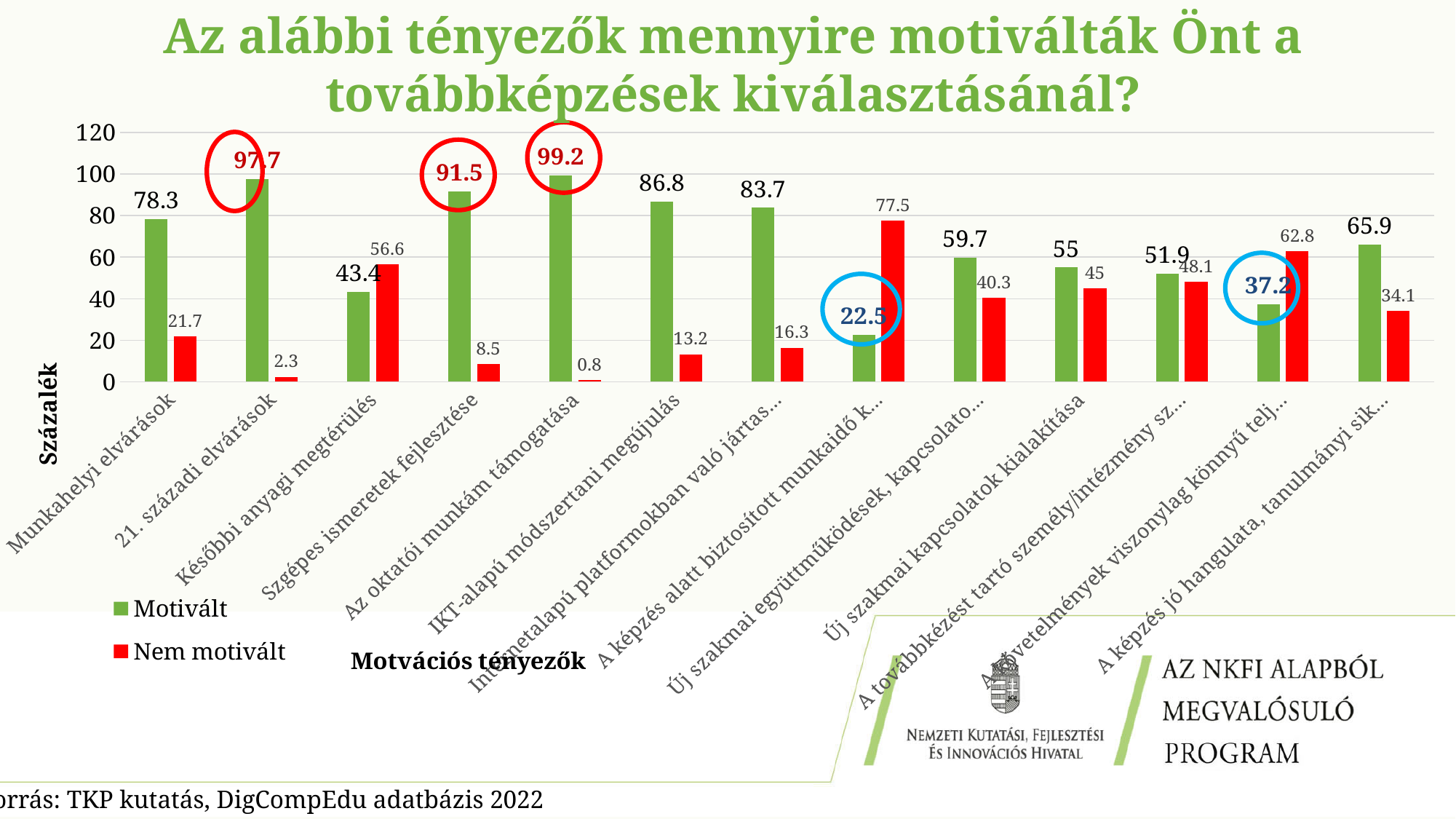
Which category has the lowest Nem motivált value? Az oktatói munkám támogatása What is the Nem motivált value for Későbbi anyagi megtérülés? 56.6 For Új szakmai kapcsolatok kialakítása, which is larger: the Motivált value or the Nem motivált value? Motivált What is the Motivált value for Munkahelyi elvárások? 78.3 How many series does the legend list? 2 What is the difference between the Motivált and Nem motivált values for 21. századi elvárások? 95.4 Which category has the highest Motivált value? Az oktatói munkám támogatása What is the Nem motivált value for Szgépes ismeretek fejlesztése? 8.5 What is the Motivált value for Az oktatói munkám támogatása? 99.2 How many categories are shown on the x axis? 13 Is the Motivált value for IKT-alapú módszertani megújulás greater or less than 80? greater What type of chart is shown on the slide? Bar chart